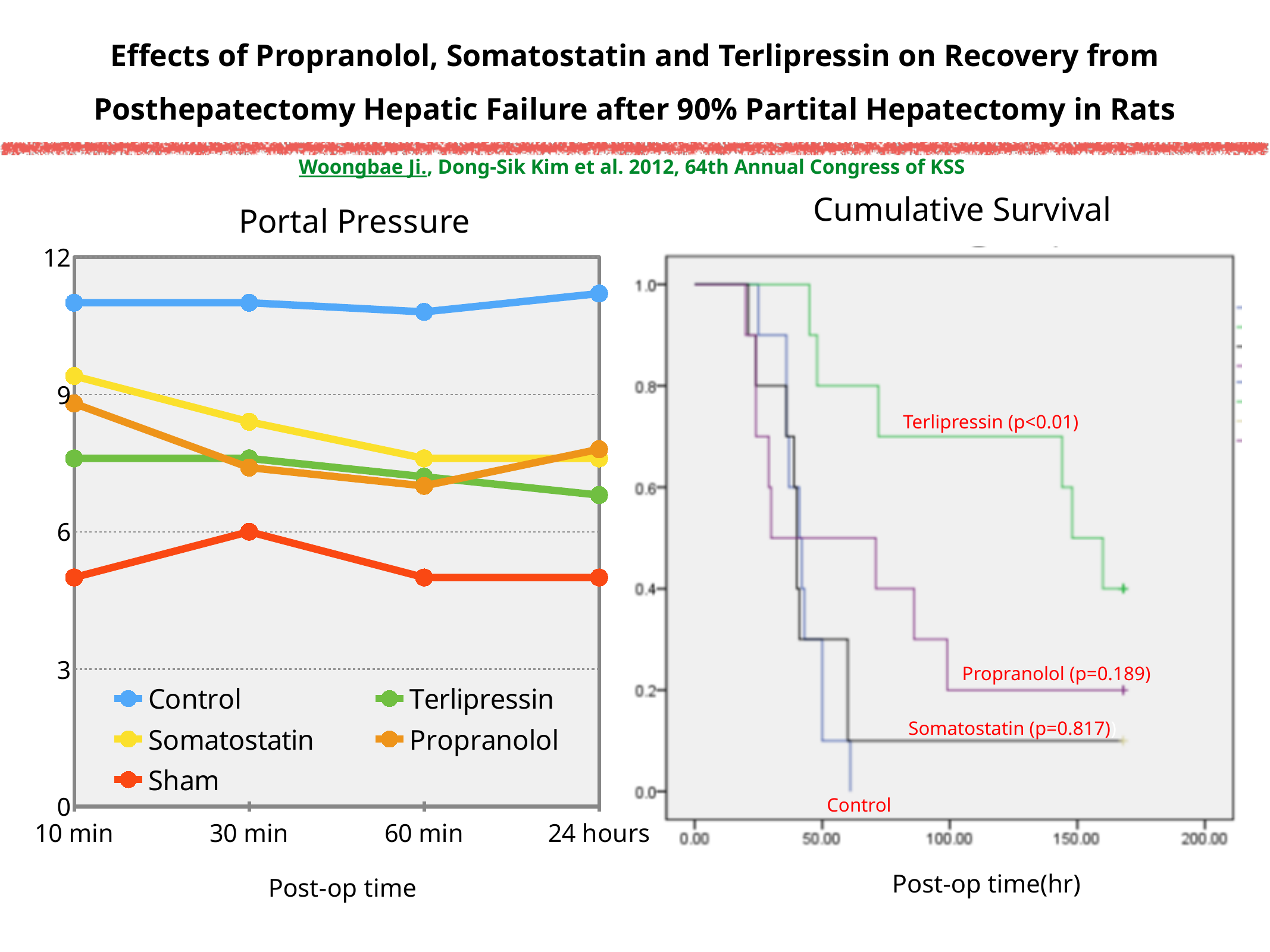
In the Portal Pressure chart, is the Control value at 10 min greater or less than 9? greater In the Portal Pressure chart, does the Somatostatin line rise or fall from 10 min to 60 min? fall In the Portal Pressure chart, which group has the highest portal pressure at 10 min? Control In the Cumulative Survival chart, which group's curve stays highest at 150 hours post-op? Terlipressin How many post-op time points are shown on the x axis of the Portal Pressure chart? 4 In the Portal Pressure chart, which is larger at 30 min: Somatostatin or Terlipressin? Somatostatin In the Portal Pressure chart, is the Somatostatin value at 10 min greater or less than 9? greater In the Portal Pressure chart, is the Sham value at 10 min greater or less than 6? less In the Portal Pressure chart, which group has the lowest portal pressure at 24 hours? Sham In the Cumulative Survival chart, what p-value is shown next to the Terlipressin label? p<0.01 How many series does the legend of the Portal Pressure chart list? 5 What kind of chart is the Portal Pressure chart? line chart